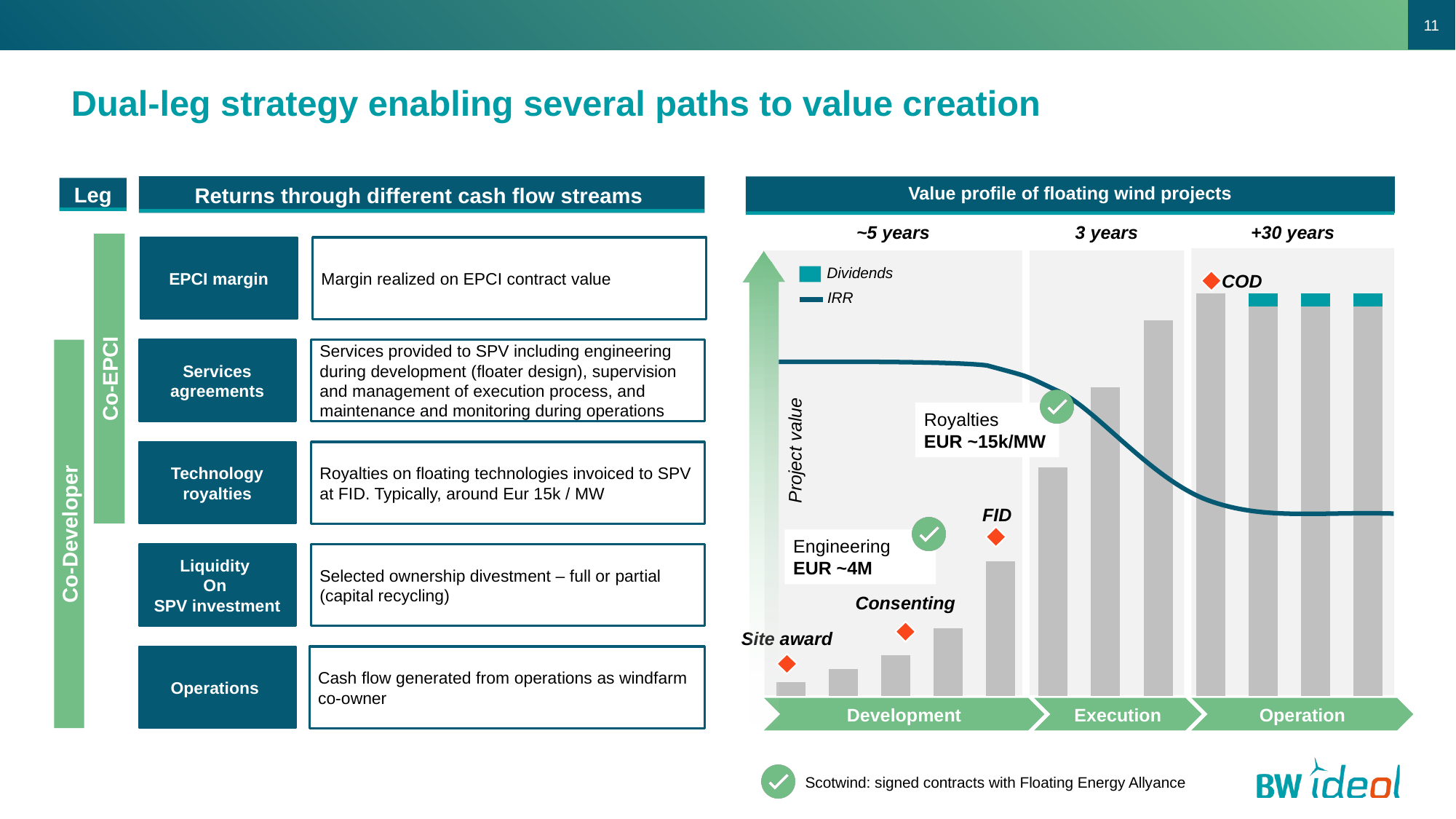
In the 'Value profile of floating wind projects' chart, does the IRR line rise or fall from the Development phase to the Operation phase? Fall In the 'Value profile of floating wind projects' chart, how long is the Execution phase stated to last? 3 years What are the two entries in the legend of the 'Value profile of floating wind projects' chart? Dividends and IRR In the 'Value profile of floating wind projects' chart, what engineering value is annotated during the Development phase? EUR ~4M In the 'Value profile of floating wind projects' chart, do the grey project value bars rise or fall from the Development phase to the Operation phase? Rise In the 'Value profile of floating wind projects' chart, which phase has the tallest project value bars, Development or Operation? Operation In the 'Value profile of floating wind projects' chart, how long is the Operation phase stated to last? +30 years What kind of chart is shown under 'Value profile of floating wind projects'? Bar chart with a line In the 'Value profile of floating wind projects' chart, what royalties value is annotated per MW? EUR ~15k/MW How many project phases are shown along the x axis of the 'Value profile of floating wind projects' chart? 3 How many series does the legend of the 'Value profile of floating wind projects' chart list? 2 What is the label on the y axis of the 'Value profile of floating wind projects' chart? Project value